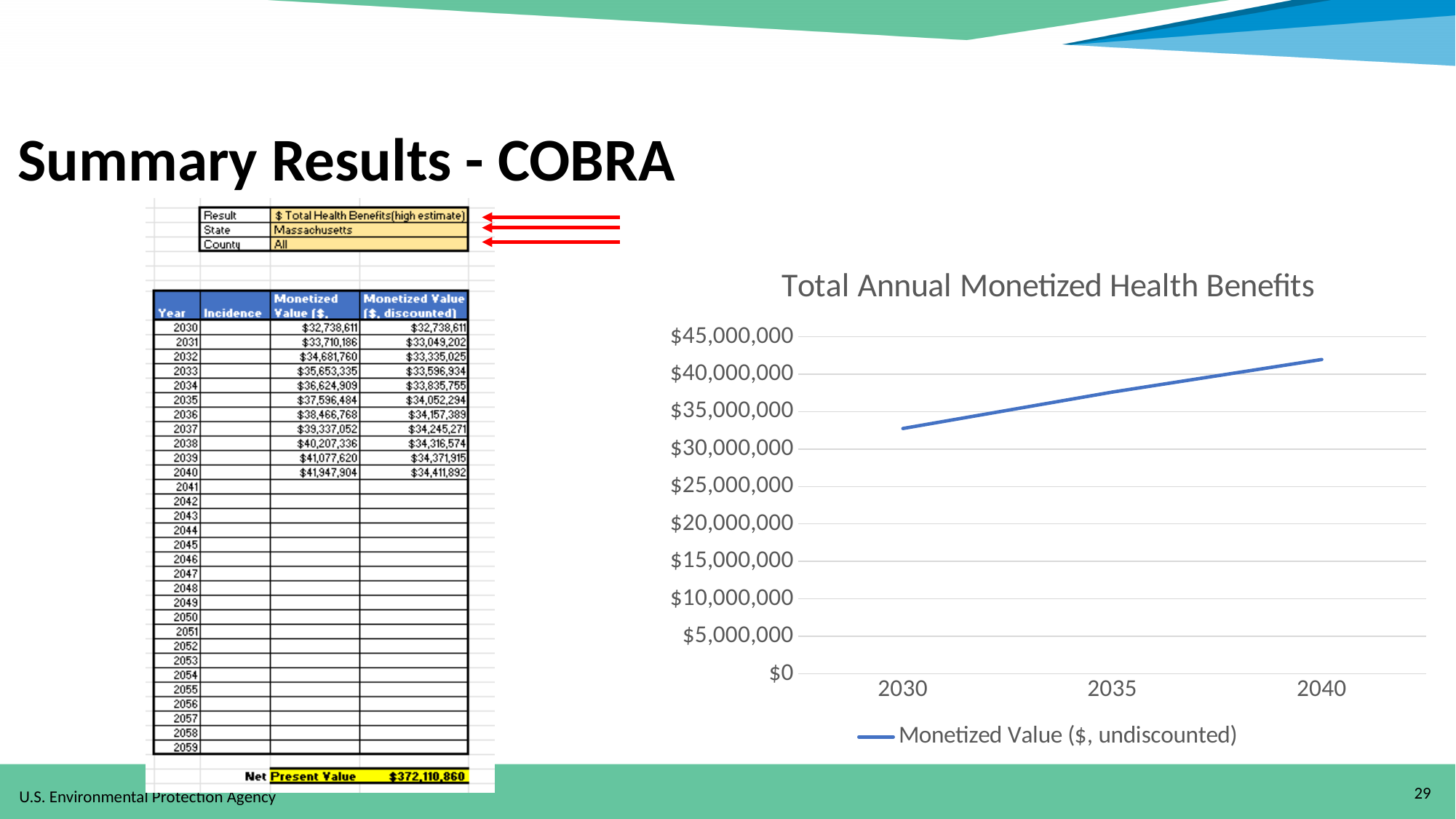
Is the value for 2030 in the chart greater or less than $35,000,000? less What kind of chart is shown on the slide? line chart Which year shown on the x axis has the highest value in the chart? 2040 Is the value for 2030 in the chart greater or less than $30,000,000? greater Do the values in the chart rise or fall from 2030 to 2040? rise What is the name of the series shown in the chart's legend? Monetized Value ($, undiscounted) Is the value for 2040 in the chart greater or less than $40,000,000? greater How many series does the chart's legend list? 1 Which is larger in the chart, the value for 2030 or the value for 2040? 2040 What is the title of the chart on the slide? Total Annual Monetized Health Benefits